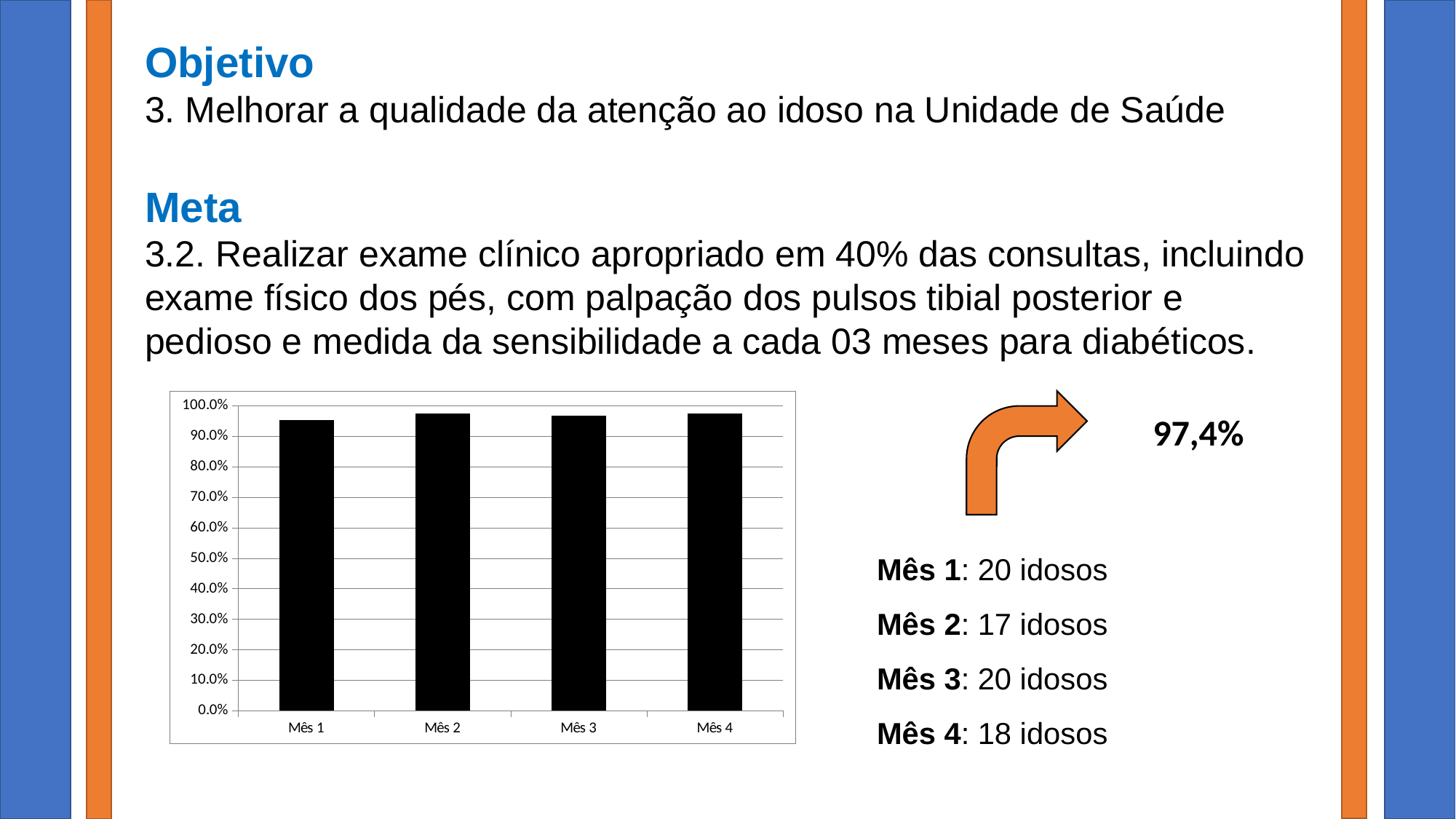
Is the value for Mês 4 greater or less than 80.0%? greater Is the value for Mês 1 greater or less than 50.0%? greater What colour are the bars in the chart? black What is the highest value shown on the chart's y axis? 100.0% What kind of chart is shown on the slide? bar chart Is the value for Mês 1 greater or less than 90.0%? greater How many categories (months) are plotted on the chart? 4